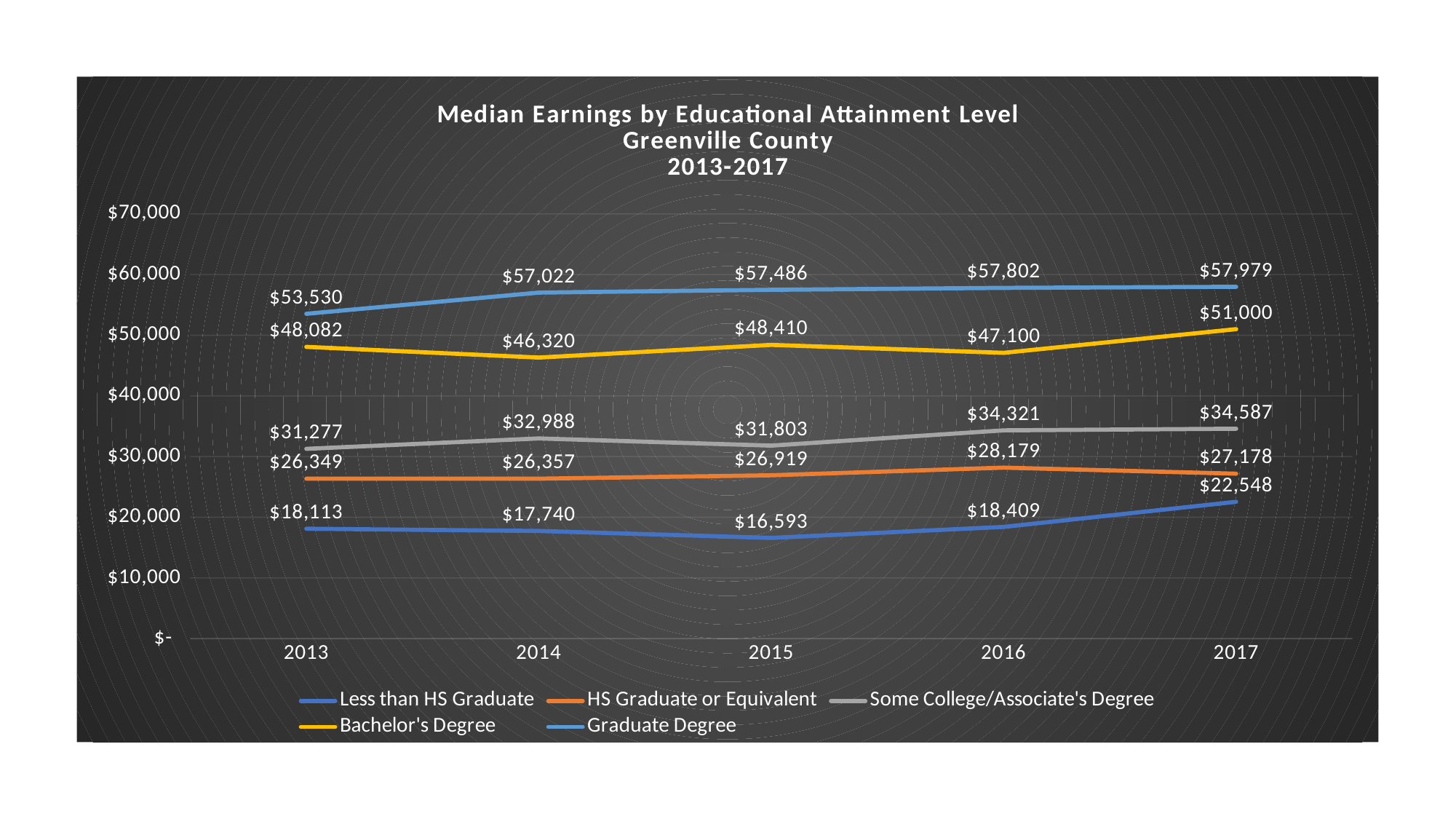
For HS Graduate or Equivalent, which year had higher median earnings, 2016 or 2017? 2016 In which year was the median earnings for Bachelor's Degree the lowest? 2014 What kind of chart is shown on the slide? Line chart What was the median earnings for Bachelor's Degree holders in 2017? $51,000 In which year was the median earnings for Less than HS Graduate the highest? 2017 Did the median earnings for Graduate Degree holders rise or fall from 2013 to 2017? Rise By how much did the median earnings for Some College/Associate's Degree increase from 2013 to 2016? $3,044 What is the difference between the Graduate Degree and Bachelor's Degree median earnings in 2017? $6,979 How many years are shown on the x axis? 5 What was the median earnings for Graduate Degree holders in 2015? $57,486 What was the median earnings for Less than HS Graduate in 2015? $16,593 How many series does the legend list? 5